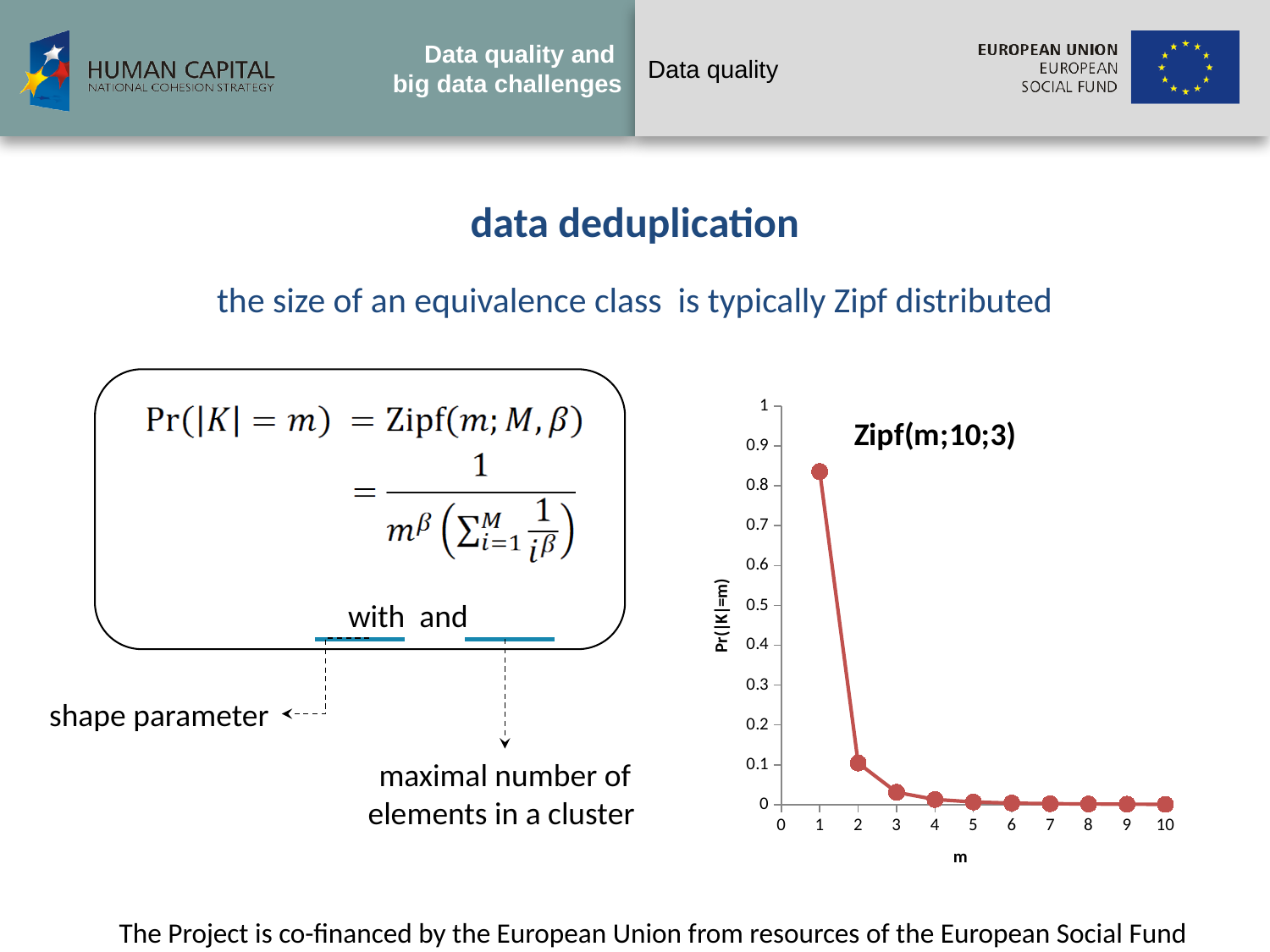
Is the value of Pr(|K|=m) at m = 3 greater or less than 0.1? less How many data points are plotted on the chart? 10 Do the plotted values rise or fall as m increases along the x axis? fall What is the title of the chart? Zipf(m;10;3) Which has a larger value of Pr(|K|=m): m = 1 or m = 2? m = 1 What kind of chart is shown on the slide? line chart What is the label of the vertical axis of the chart? Pr(|K|=m) What is the highest tick value shown on the vertical axis of the chart? 1 At which value of m is Pr(|K|=m) highest? 1 Is the value of Pr(|K|=m) at m = 2 greater or less than 0.2? less Is the value of Pr(|K|=m) at m = 1 greater or less than 0.5? greater